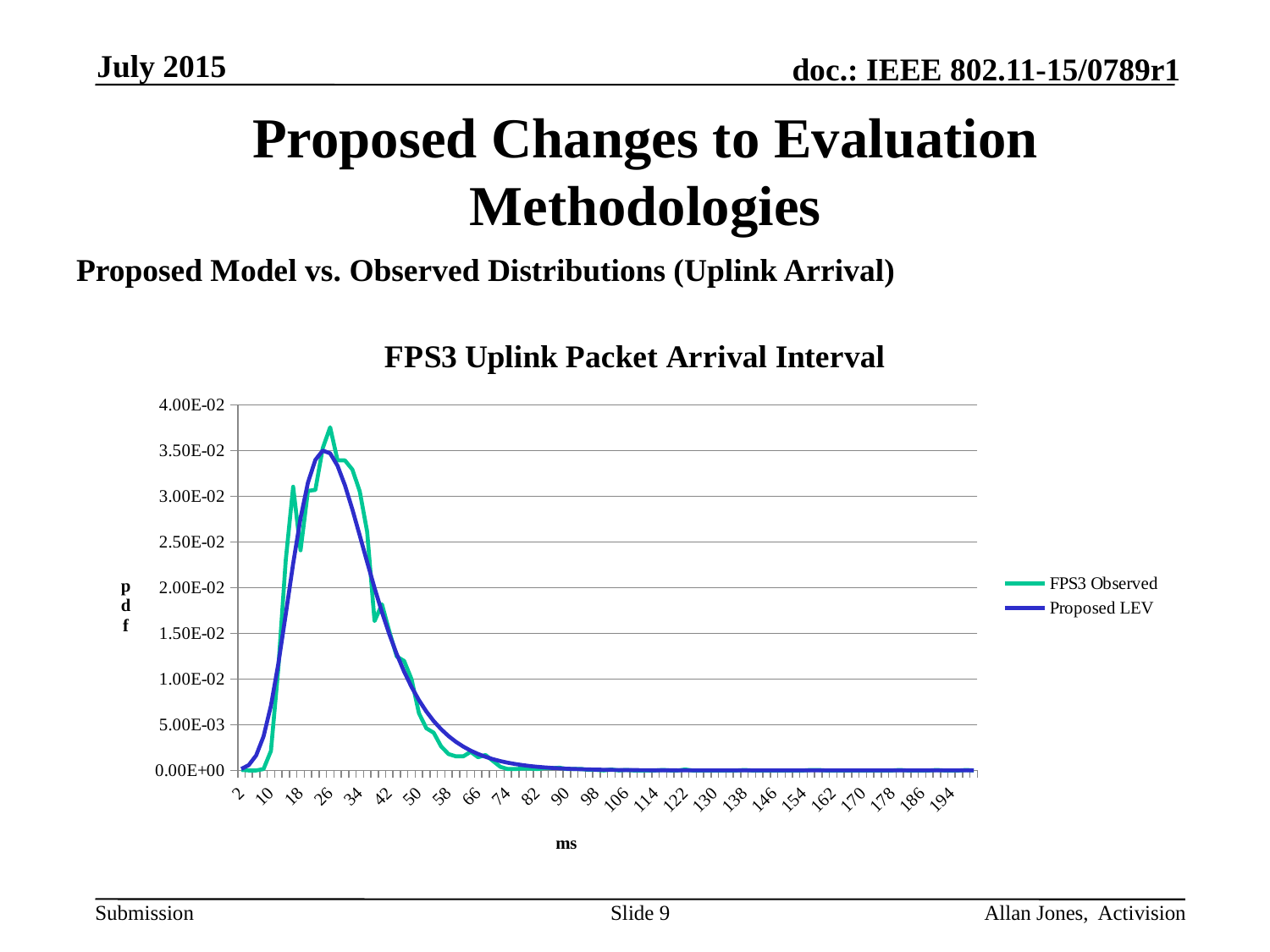
How many series does the legend list? 2 Between 2 ms and 26 ms, do the values of the Proposed LEV series rise or fall? rise What are the two series named in the legend? FPS3 Observed and Proposed LEV What kind of chart is shown on the slide? line chart Is the value of the Proposed LEV series at 2 ms greater or less than 5.00E-03? less After the peak near 26 ms, do the values of the Proposed LEV series rise or fall as ms increases? fall Is the peak value of the FPS3 Observed series greater or less than 3.50E-02? greater What is the title of the chart? FPS3 Uplink Packet Arrival Interval Which series reaches the higher peak value, FPS3 Observed or Proposed LEV? FPS3 Observed Is the value of the FPS3 Observed series at 106 ms greater or less than 5.00E-03? less